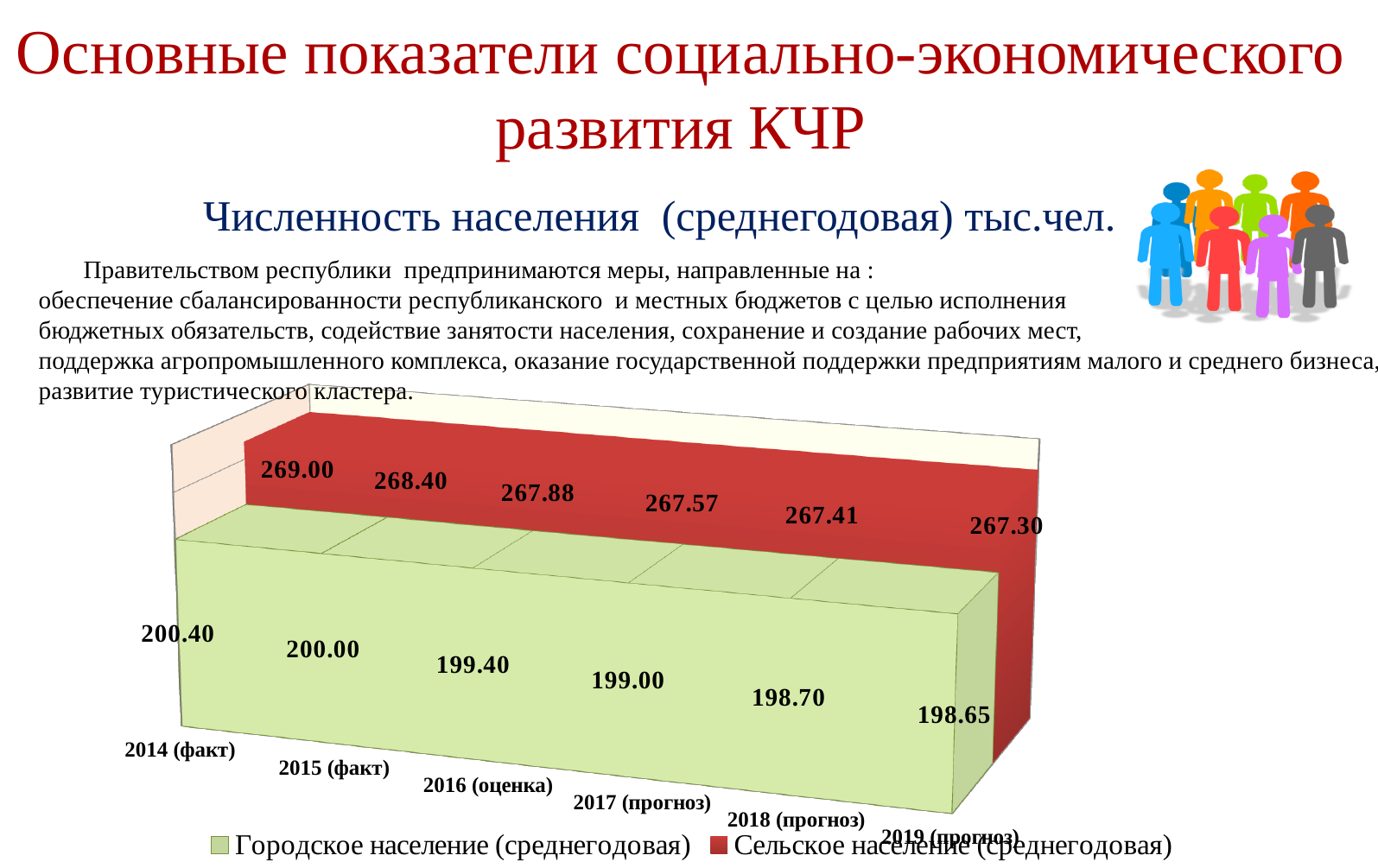
What is the value for Сельское население (среднегодовая) in 2019 (прогноз)? 267.30 What kind of chart is shown on the slide? Area chart What is the value for Городское население (среднегодовая) in 2014 (факт)? 200.40 How many years (categories) are shown on the x axis? 6 Which is larger in 2017 (прогноз): Городское население or Сельское население? Сельское население Do the values for Сельское население (среднегодовая) rise or fall from 2014 to 2019? Fall What is the difference between the Городское население values for 2014 (факт) and 2019 (прогноз)? 1.75 How many series does the legend list? 2 In which year is the value for Сельское население (среднегодовая) highest? 2014 (факт) What is the value for Городское население (среднегодовая) in 2018 (прогноз)? 198.70 In which year is the value for Городское население (среднегодовая) lowest? 2019 (прогноз) What is the value for Сельское население (среднегодовая) in 2016 (оценка)? 267.88